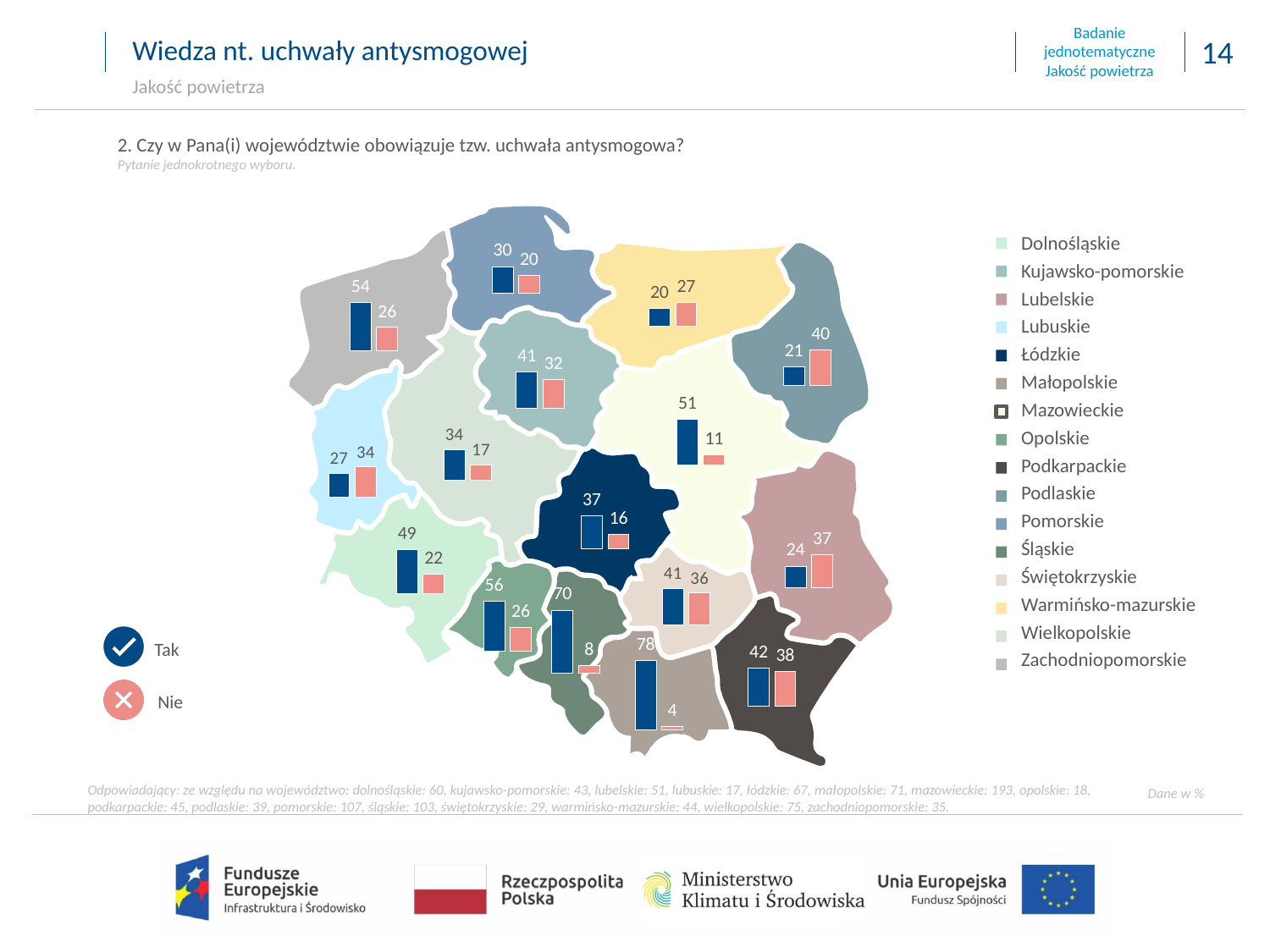
In what unit are the values on the chart given? % What is the 'Tak' value for Małopolskie? 78 What is the difference between the 'Tak' and 'Nie' values for Zachodniopomorskie? 28 Which voivodeship has the lowest 'Tak' value? Warmińsko-mazurskie What is the 'Nie' value for Śląskie? 8 Which voivodeship has the lowest 'Nie' value? Małopolskie What is the 'Tak' value for Mazowieckie? 51 How many voivodeships are listed in the legend? 16 What is the 'Nie' value for Podlaskie? 40 Which is larger for Lubelskie, the 'Tak' value or the 'Nie' value? Nie Which voivodeship has the highest 'Tak' value? Małopolskie How many answer series (Tak/Nie) are shown for each voivodeship? 2